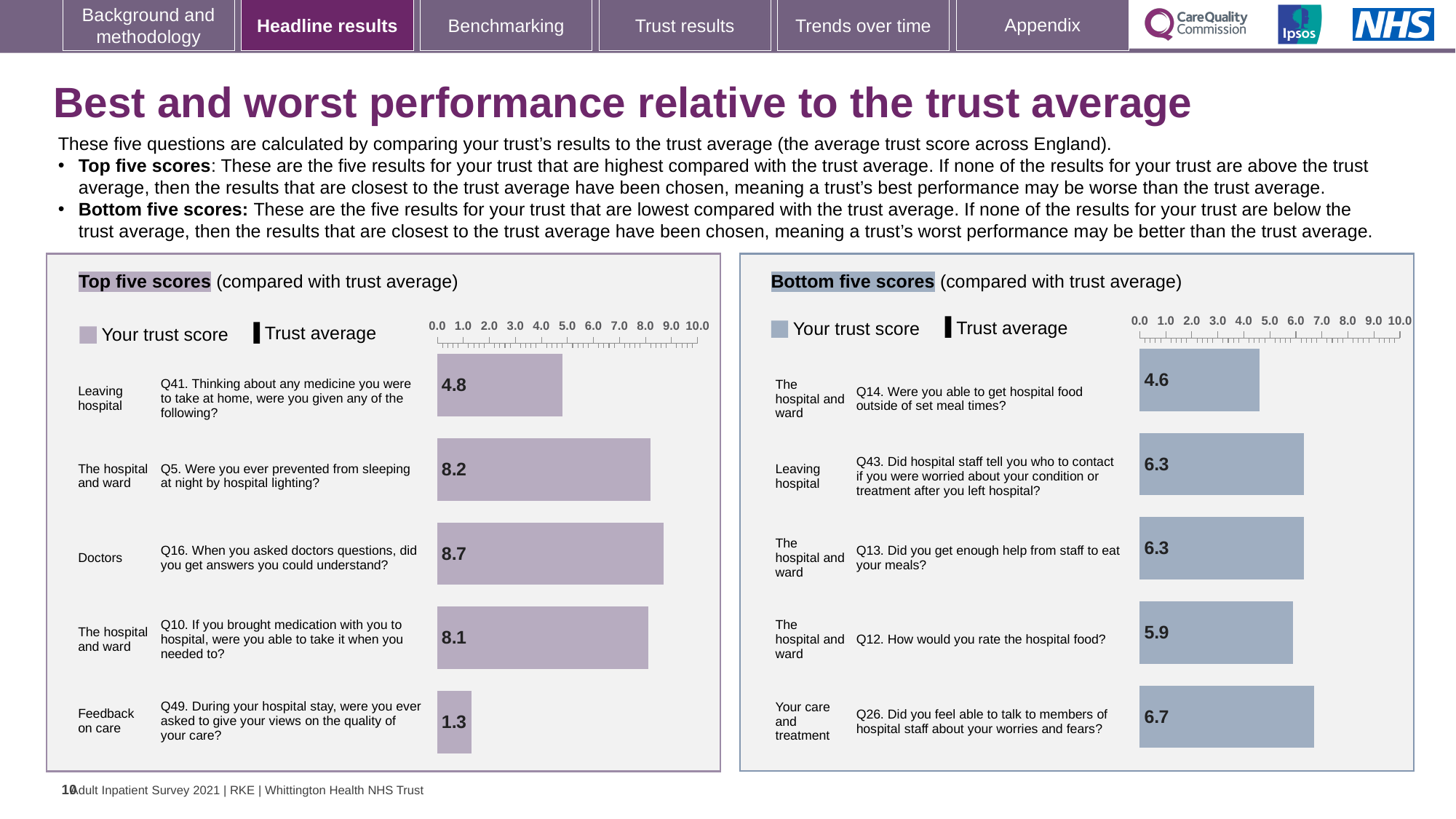
How many questions are plotted in the Bottom five scores chart? 5 In the Bottom five scores chart, which question has the lowest trust score? Q14 In the Top five scores chart, what is the difference between the trust scores for Q5 and Q41? 3.4 In the Top five scores chart, which question has the highest trust score? Q16 In the Top five scores chart, what is the trust score for Q49 (During your hospital stay, were you ever asked to give your views on the quality of your care?)? 1.3 In the Bottom five scores chart, what is the trust score for Q26 (Did you feel able to talk to members of hospital staff about your worries and fears?)? 6.7 In the Top five scores chart, what is the trust score for Q16 (When you asked doctors questions, did you get answers you could understand?)? 8.7 In the Top five scores chart, is the trust score for Q10 greater or less than 7.0? greater In the Bottom five scores chart, what is the maximum value shown on the axis? 10.0 What kind of chart is the Top five scores chart? Bar chart In the Bottom five scores chart, what is the trust score for Q12 (How would you rate the hospital food?)? 5.9 In the Bottom five scores chart, which has the larger trust score, Q26 or Q12? Q26